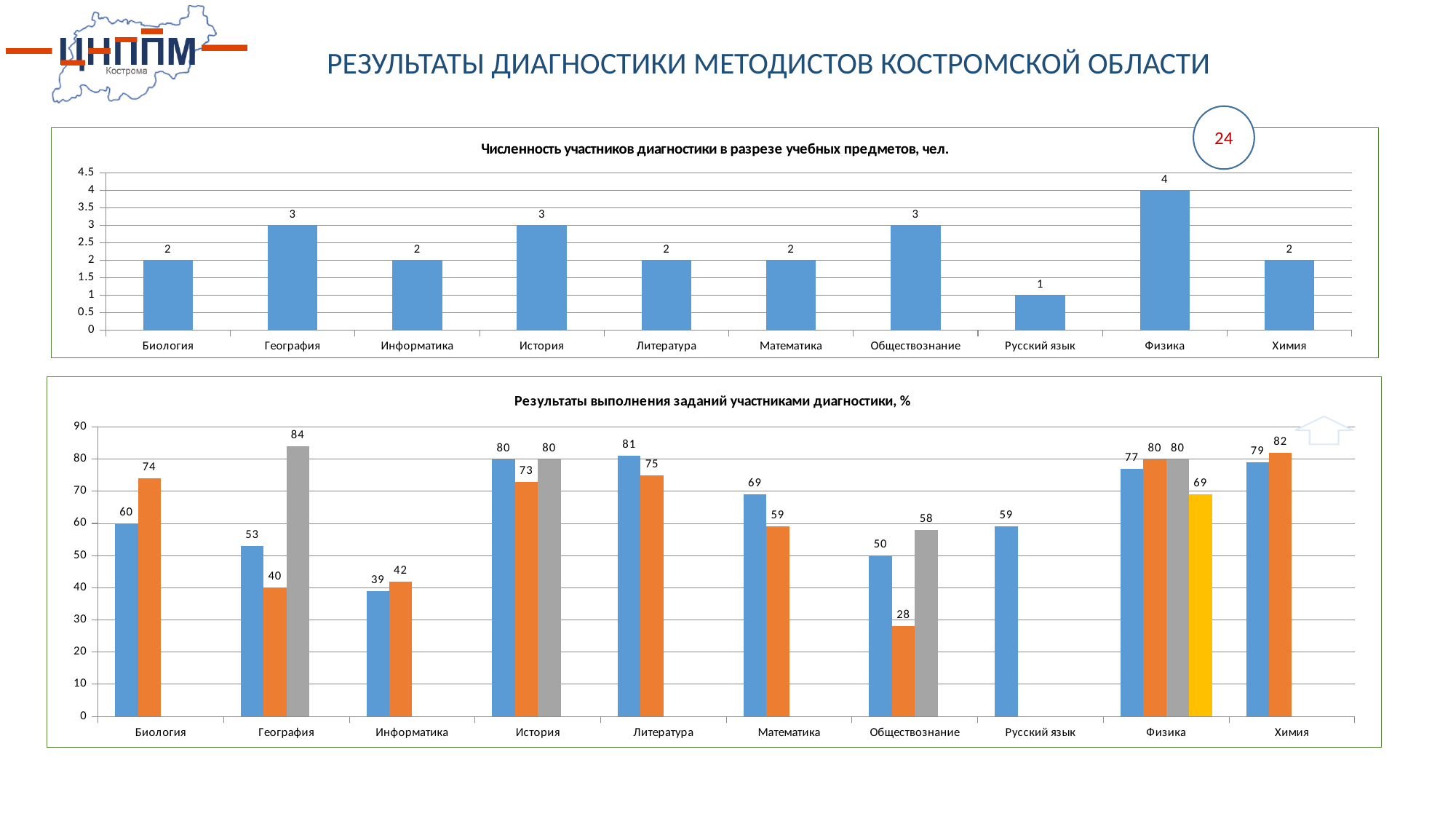
In the top chart 'Численность участников диагностики в разрезе учебных предметов, чел.', what is the difference between the values for Физика and Русский язык? 3 In the bottom chart 'Результаты выполнения заданий участниками диагностики, %', which is larger for Биология: the blue bar or the orange bar? The orange bar What type of chart is the top chart 'Численность участников диагностики в разрезе учебных предметов, чел.'? Bar chart In the bottom chart 'Результаты выполнения заданий участниками диагностики, %', what is the value of the orange bar for Обществознание? 28 In the bottom chart 'Результаты выполнения заданий участниками диагностики, %', what is the difference between the blue bar and the orange bar for Информатика? 3 In the bottom chart 'Результаты выполнения заданий участниками диагностики, %', what is the value of the gray bar for География? 84 In the bottom chart 'Результаты выполнения заданий участниками диагностики, %', how many bars are shown for Физика? 4 In the top chart 'Численность участников диагностики в разрезе учебных предметов, чел.', which subject has the highest value? Физика In the bottom chart 'Результаты выполнения заданий участниками диагностики, %', what is the value of the yellow bar for Физика? 69 In the top chart 'Численность участников диагностики в разрезе учебных предметов, чел.', which subject has the lowest value? Русский язык In the top chart 'Численность участников диагностики в разрезе учебных предметов, чел.', how many subjects are shown on the x axis? 10 In the top chart 'Численность участников диагностики в разрезе учебных предметов, чел.', what is the value for Физика? 4